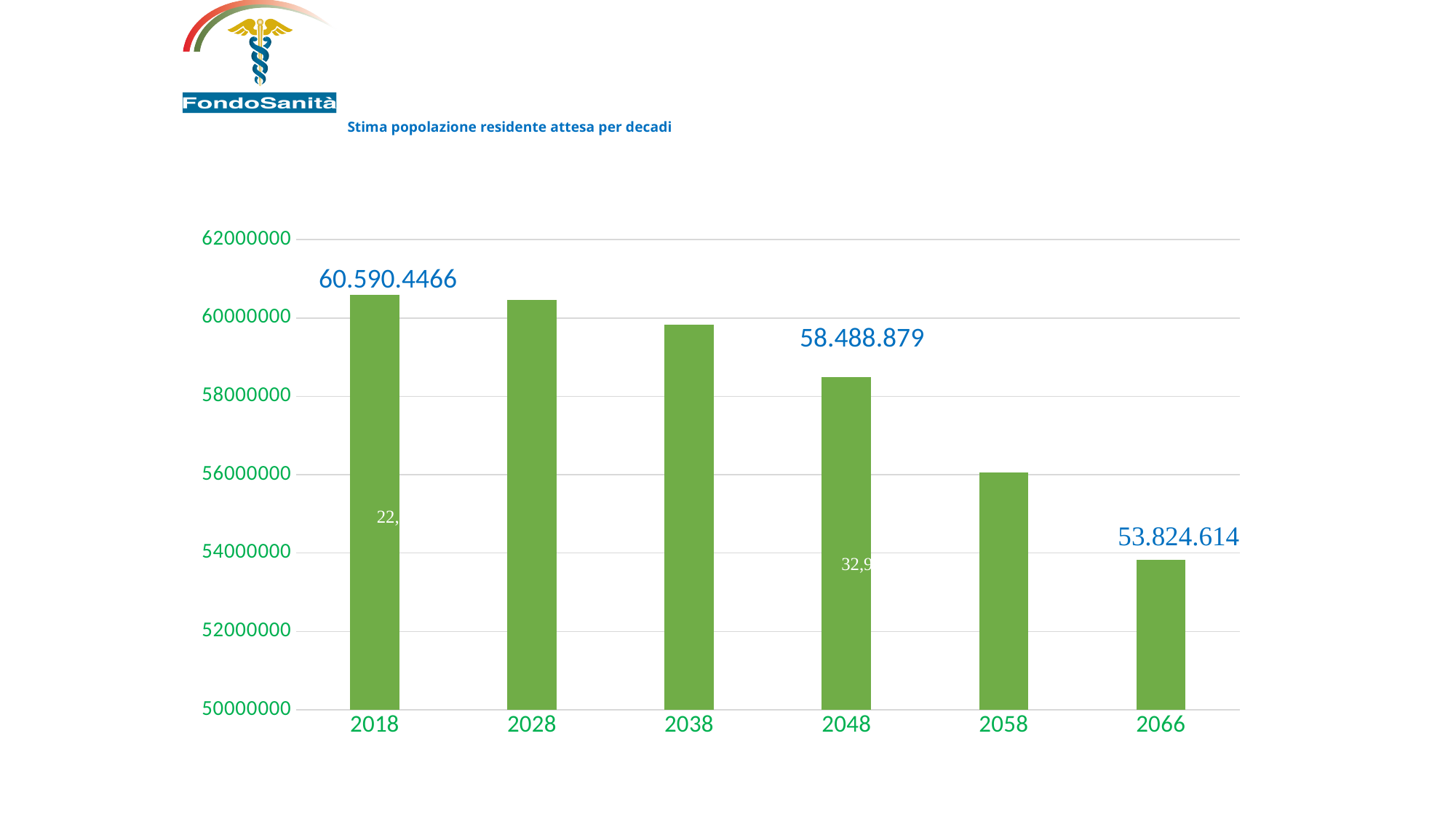
Which year has the highest bar in the chart? 2018 What kind of chart is shown on the slide? bar chart Do the values rise or fall from 2018 to 2066? fall What is the value labelled for 2018? 60.590.4466 What is the value labelled for 2066? 53.824.614 What is the difference between the labelled values for 2048 and 2066? 4.664.265 Which year has the lowest bar in the chart? 2066 Is the value for 2038 greater or less than 58000000? greater Is the value for 2058 greater or less than 58000000? less What is the value labelled for 2048? 58.488.879 What is the title of the chart? Stima popolazione residente attesa per decadi How many years are shown on the x axis of the chart? 6